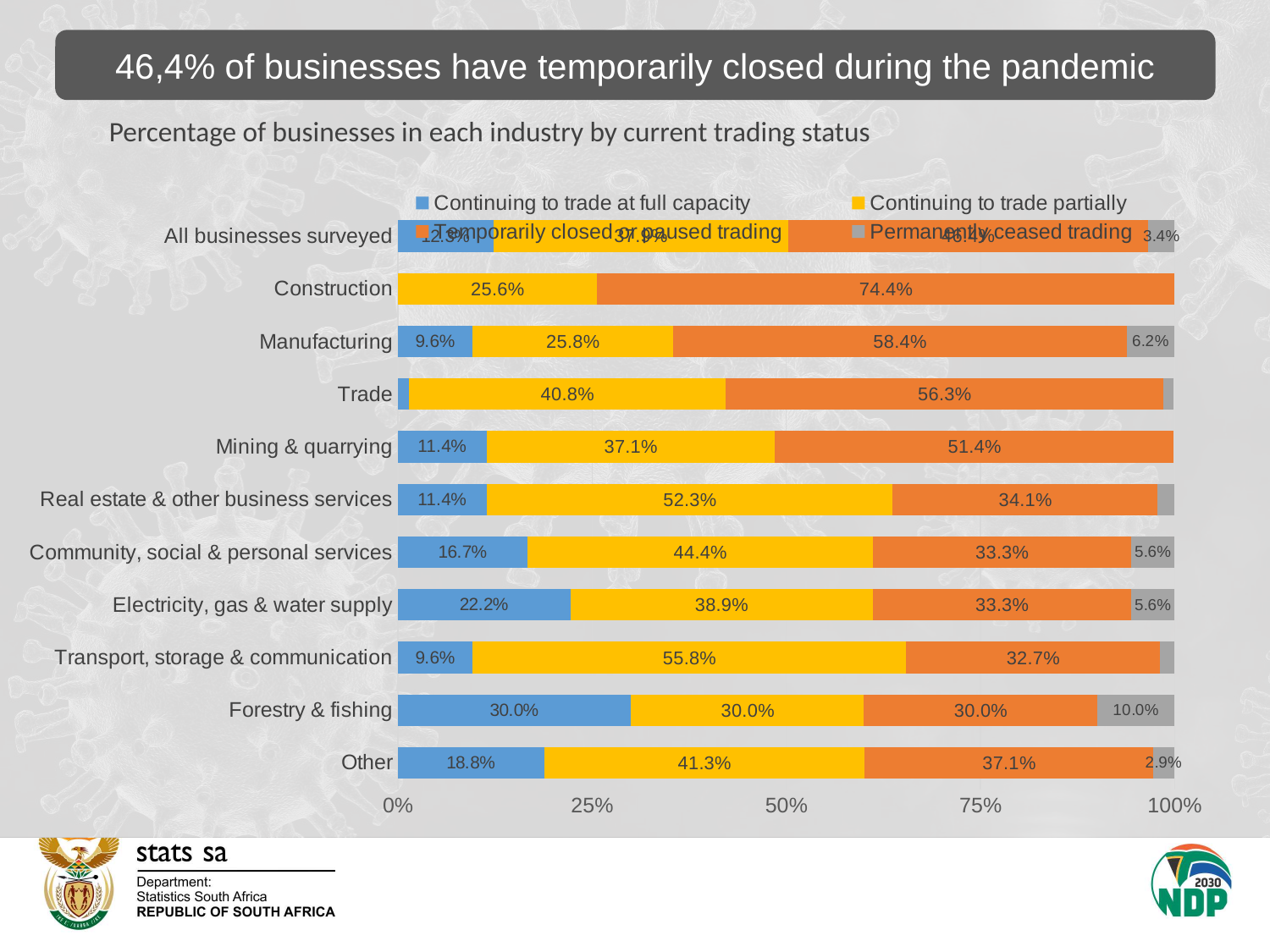
What percentage of Forestry & fishing businesses had permanently ceased trading? 10.0% Which industry has the highest percentage of businesses continuing to trade at full capacity? Forestry & fishing What percentage of Construction businesses were temporarily closed or paused trading? 74.4% Which colour represents 'Continuing to trade partially' in the chart? Yellow What is the difference between the percentage of Transport, storage & communication businesses continuing to trade partially and those temporarily closed or paused trading? 23.1% Which is larger: the percentage of Real estate & other business services businesses continuing to trade partially, or the percentage of Mining & quarrying businesses continuing to trade partially? Real estate & other business services Which industry has the highest percentage of businesses temporarily closed or paused trading? Construction How many industry categories are shown on the chart, including 'All businesses surveyed'? 11 Is the percentage of Trade businesses temporarily closed or paused trading greater or less than 50%? greater What kind of chart is shown on the slide? Stacked bar chart How many series does the legend list? 4 What percentage of Manufacturing businesses were continuing to trade at full capacity? 9.6%